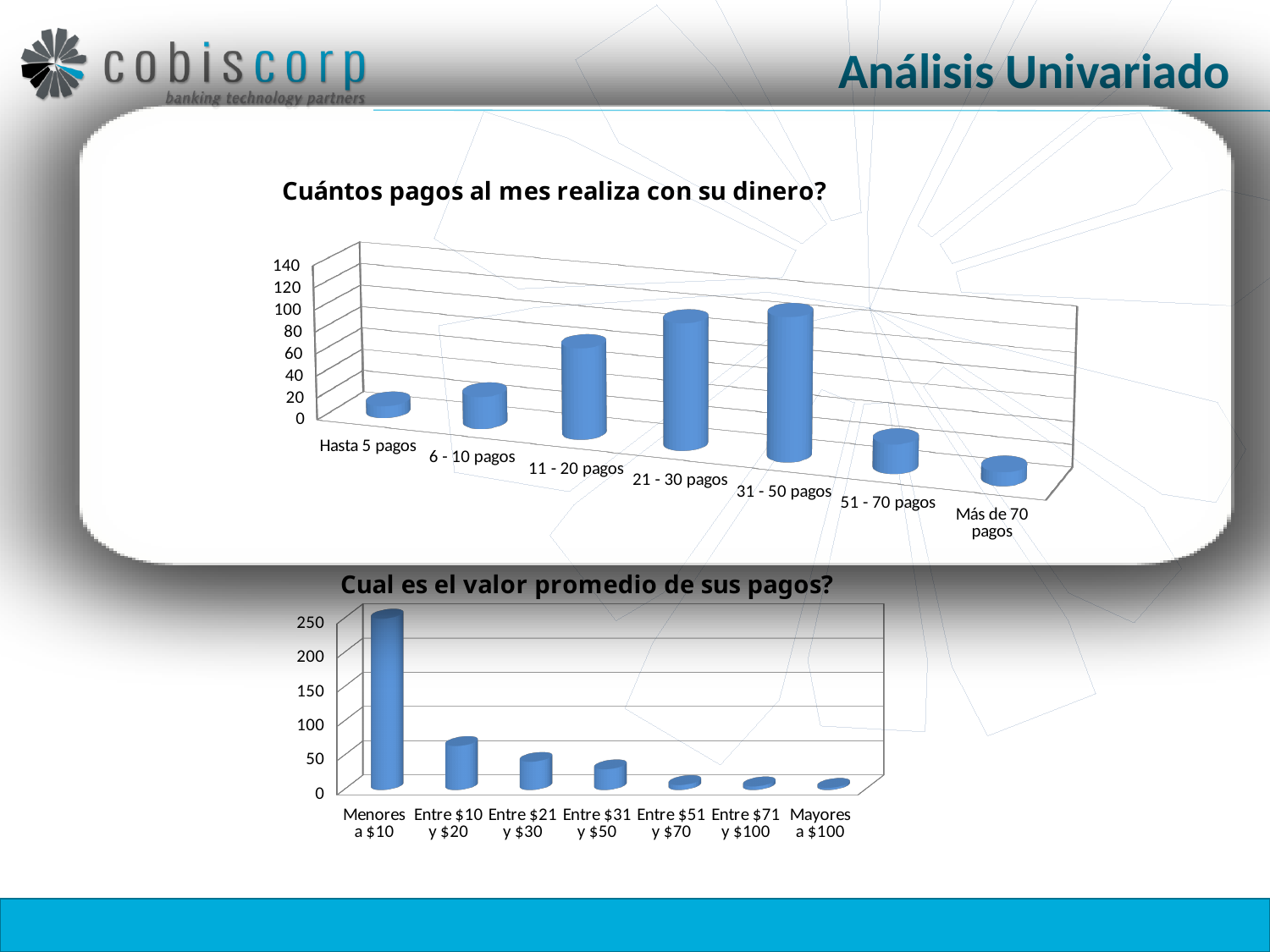
In the bottom chart 'Cual es el valor promedio de sus pagos?', do the values generally rise or fall from left to right along the x axis? fall In the bottom chart 'Cual es el valor promedio de sus pagos?', is the value for 'Menores a $10' greater or less than 200? greater How many categories are shown in the top chart 'Cuántos pagos al mes realiza con su dinero?'? 7 In the bottom chart 'Cual es el valor promedio de sus pagos?', is the value for 'Entre $31 y $50' greater or less than 50? less In the top chart 'Cuántos pagos al mes realiza con su dinero?', which is larger, the value for '11 - 20 pagos' or the value for '51 - 70 pagos'? 11 - 20 pagos In the top chart 'Cuántos pagos al mes realiza con su dinero?', is the value for 'Hasta 5 pagos' greater or less than 40? less What is the title of the bottom chart on the slide? Cual es el valor promedio de sus pagos? How many categories are shown in the bottom chart 'Cual es el valor promedio de sus pagos?'? 7 In the bottom chart 'Cual es el valor promedio de sus pagos?', which category has the highest value? Menores a $10 What type of chart is the top chart titled 'Cuántos pagos al mes realiza con su dinero?'? bar chart In the bottom chart 'Cual es el valor promedio de sus pagos?', which is larger, the value for 'Entre $10 y $20' or the value for 'Entre $51 y $70'? Entre $10 y $20